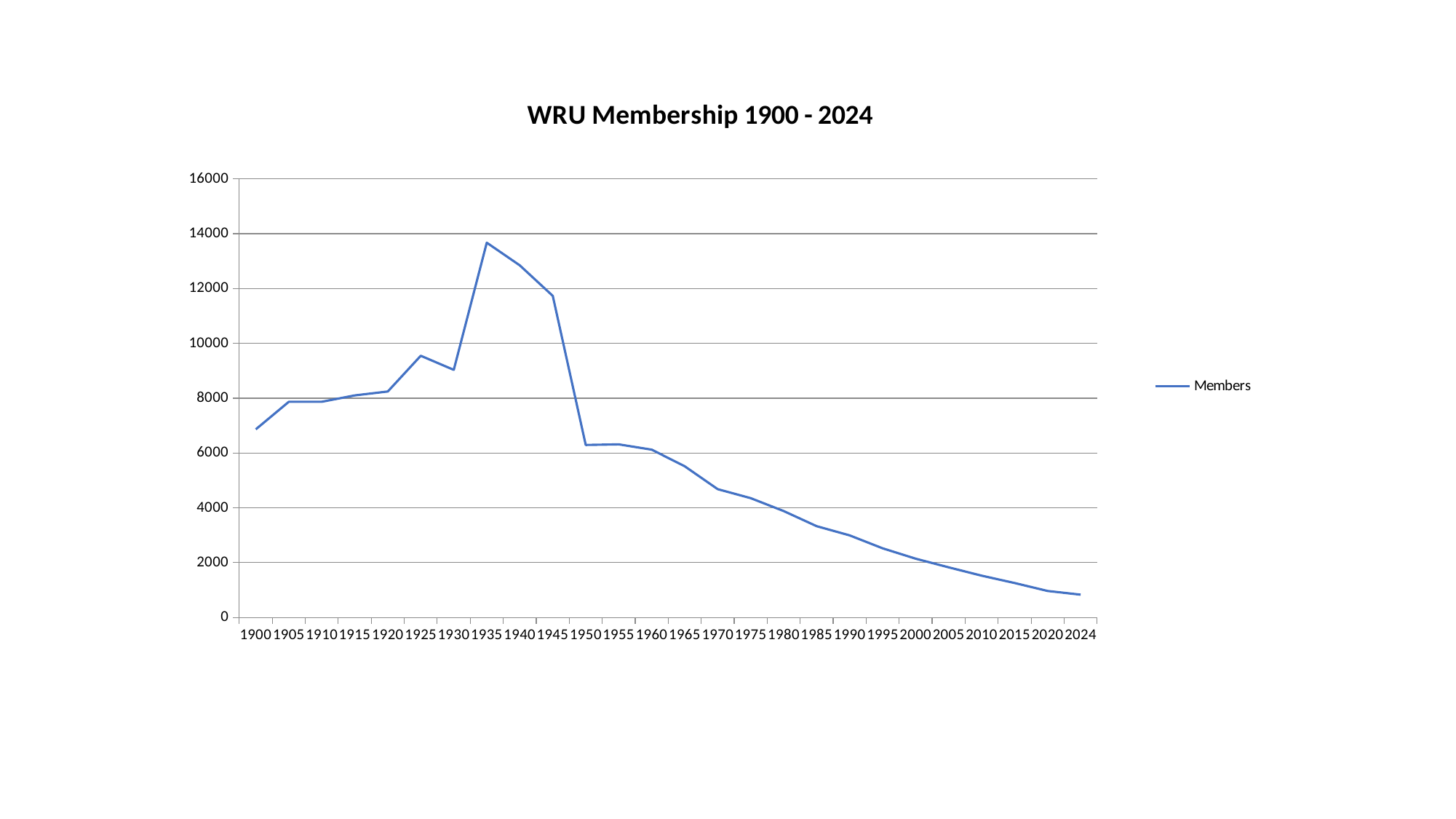
How many series does the legend list? 1 Is the value for 1900 greater or less than 8000? less Is the value for 1935 greater or less than 12000? greater In which year is membership highest? 1935 What is the name of the series shown in the legend? Members Which year has the larger membership, 1935 or 1945? 1935 What is the title of the chart? WRU Membership 1900 - 2024 Is the value for 1970 greater or less than 6000? less What kind of chart is shown on the slide? line chart How many years are labelled along the x axis? 26 In which year is membership lowest? 2024 Do membership values rise or fall from 1950 to 2024? fall